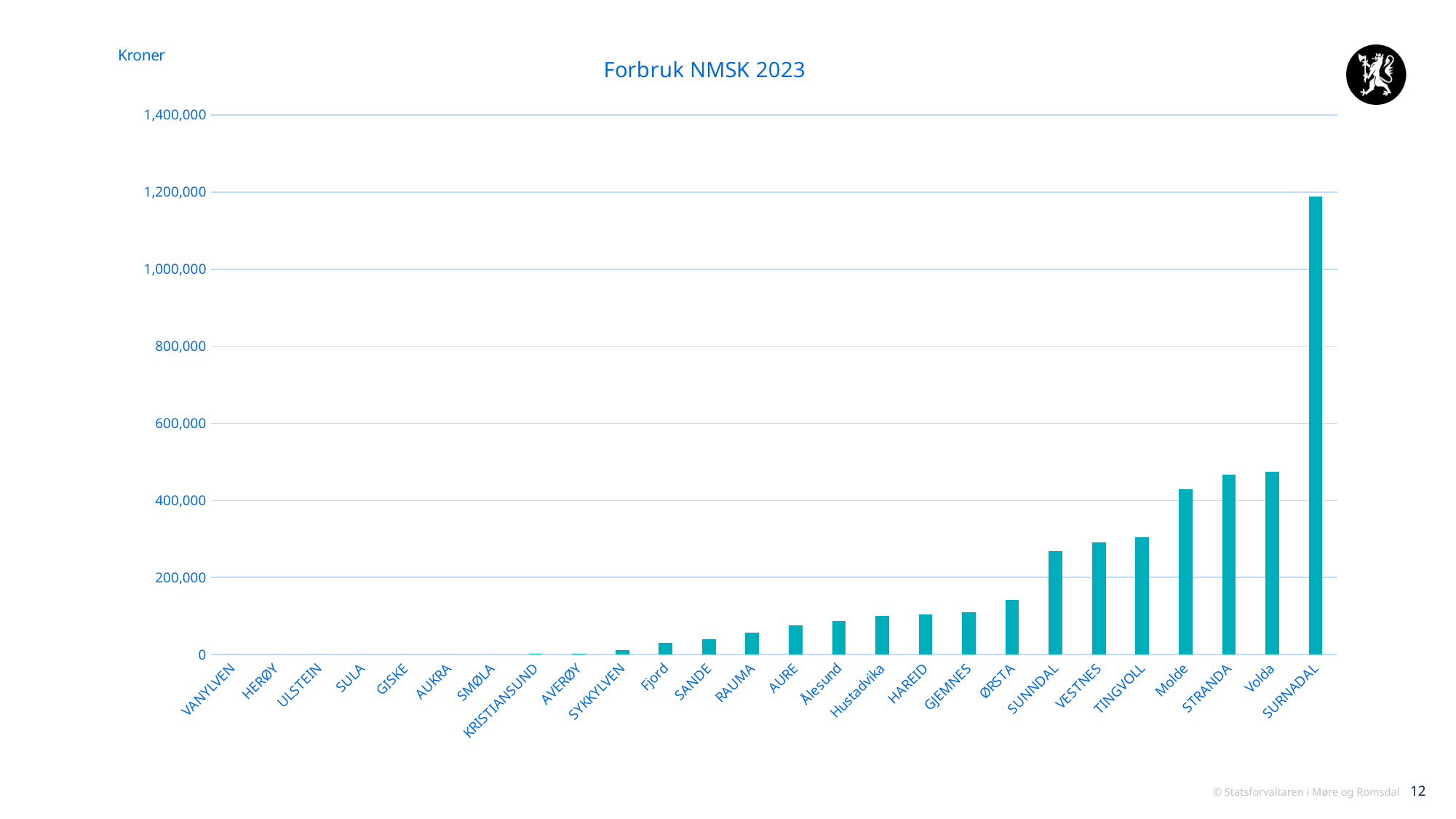
What unit label is shown above the vertical axis? Kroner Is the value for VESTNES greater or less than 400,000? less Do the values generally rise or fall moving from left to right along the x axis? rise Is the value for SURNADAL greater or less than 1,000,000? greater Which municipality has the highest value? SURNADAL How many municipalities (categories) are shown on the x axis? 26 What is the title of the chart? Forbruk NMSK 2023 Which is larger, the value for Molde or the value for SUNNDAL? Molde Is the value for Molde greater or less than 400,000? greater What kind of chart is shown on the slide? bar chart